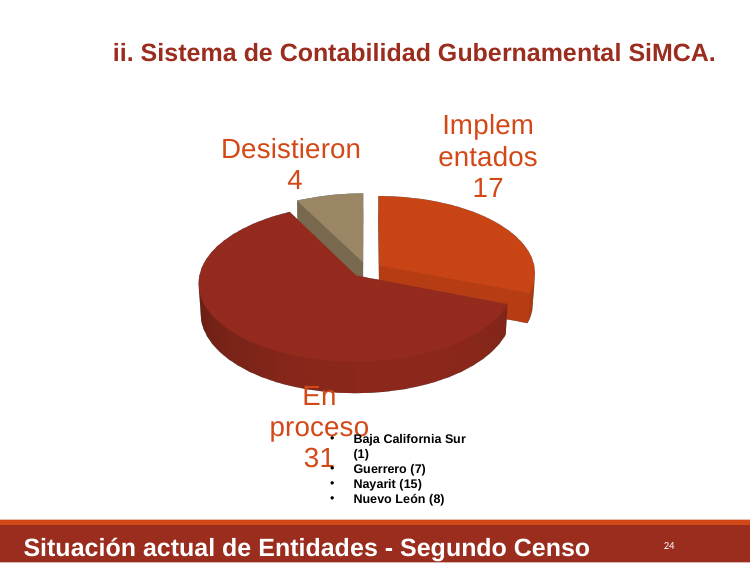
What is the value for the 'Desistieron' slice? 4 What is the title shown above the chart? ii. Sistema de Contabilidad Gubernamental SiMCA. What type of chart is shown on the slide? Pie chart What is the total of all three slices in the pie chart? 52 How many slices does the pie chart have? 3 Which category has the smallest slice of the pie? Desistieron What is the difference between the 'En proceso' and 'Implementados' values? 14 What is the difference between the 'Implementados' and 'Desistieron' values? 13 Which category has the largest slice of the pie? En proceso What is the value for the 'Implementados' slice? 17 Which is larger, 'Implementados' or 'Desistieron'? Implementados What is the value for the 'En proceso' slice? 31